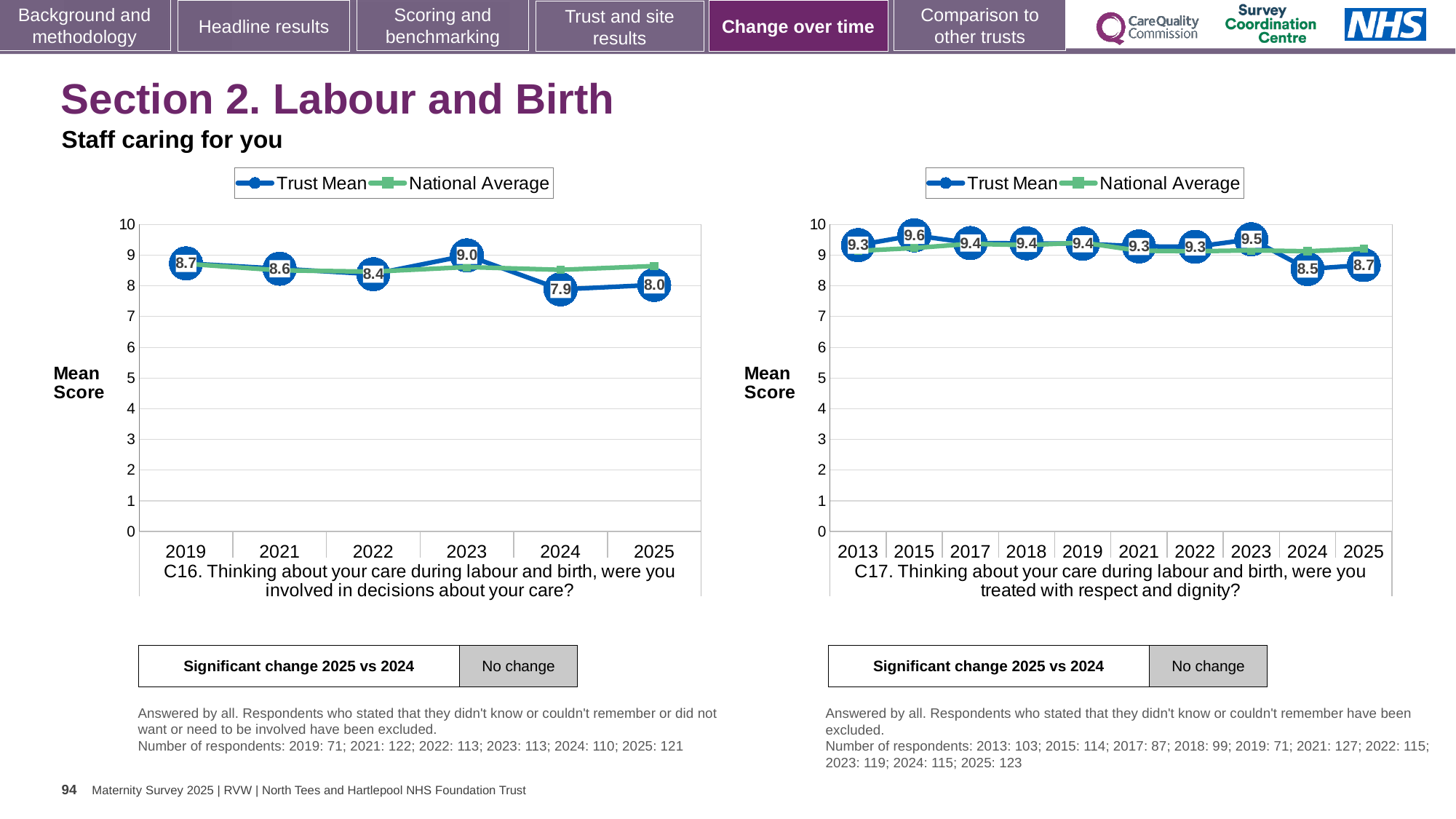
In the C16 chart (left), how many years are shown on the x axis? 6 In the C16 chart (left), what is the Trust Mean for 2023? 9.0 In the C16 chart (left), which year has the highest Trust Mean? 2023 In the C16 chart (left), which year has the lowest Trust Mean? 2024 In the C16 chart (left), what is the difference between the Trust Mean for 2023 and 2024? 1.1 In the C17 chart (right), how many series does the legend list? 2 In the C17 chart (right), which year has the lowest Trust Mean? 2024 In the C17 chart (right), is the Trust Mean for 2025 greater or less than the Trust Mean for 2023? less In the C16 chart (left), what is the Trust Mean for 2025? 8.0 In the C17 chart (right), what is the Trust Mean for 2024? 8.5 In the C17 chart (right), what is the Trust Mean for 2015? 9.6 What kind of chart is the C17 chart (right)? Line chart